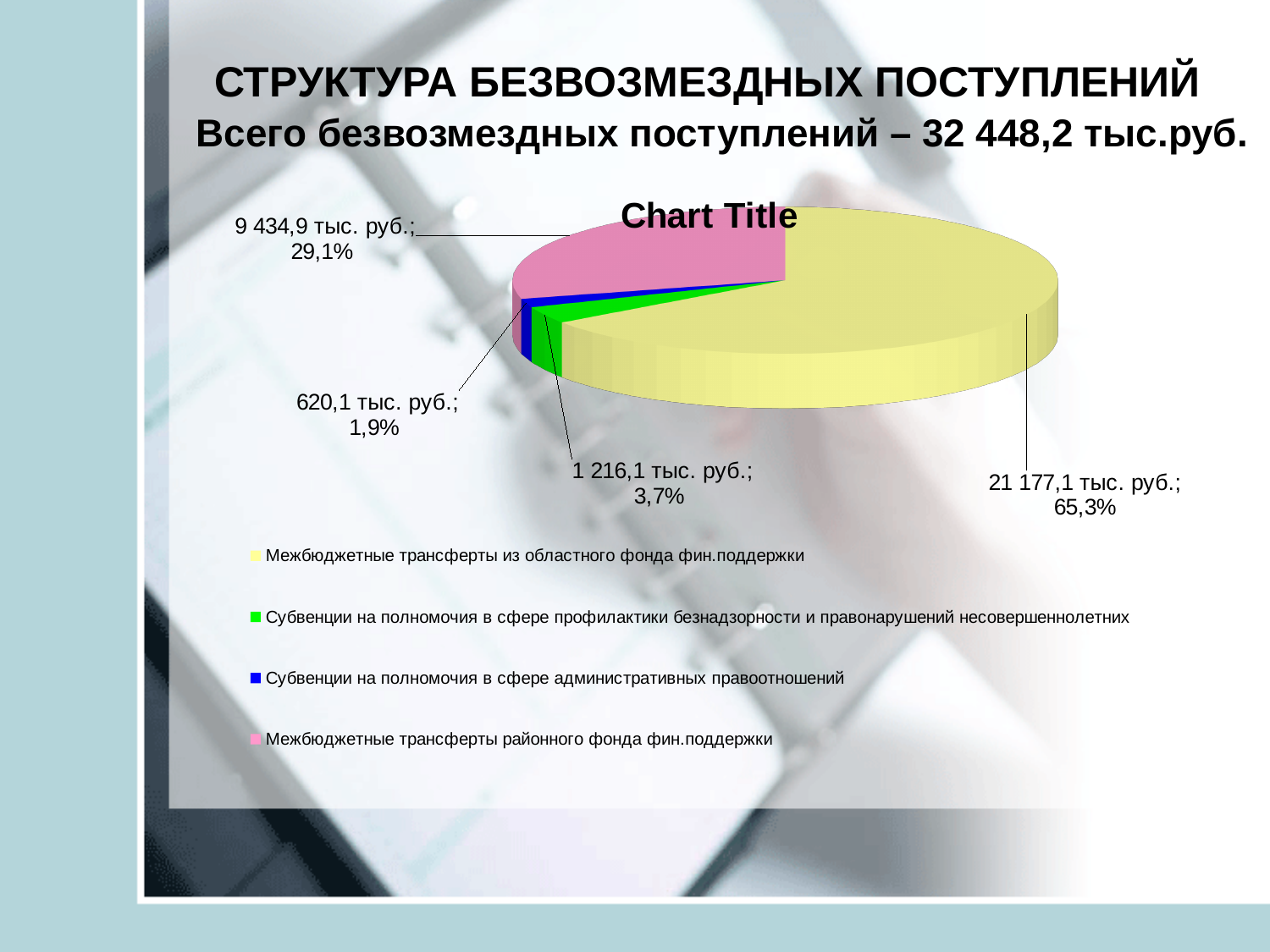
What kind of chart is shown on the slide? pie chart What share of the pie is Субвенции на полномочия в сфере административных правоотношений? 1,9% What value is shown for Межбюджетные трансферты из областного фонда фин.поддержки? 21 177,1 тыс. руб. How many entries does the legend list? 4 How many slices does the pie chart have? 4 What share of the pie is Межбюджетные трансферты районного фонда фин.поддержки? 29,1% What colour is the slice for Межбюджетные трансферты районного фонда фин.поддержки? pink Which category has the smallest slice of the pie? Субвенции на полномочия в сфере административных правоотношений What value is shown for Субвенции на полномочия в сфере профилактики безнадзорности и правонарушений несовершеннолетних? 1 216,1 тыс. руб. What is the difference in percentage share between Межбюджетные трансферты из областного фонда фин.поддержки and Межбюджетные трансферты районного фонда фин.поддержки? 36,2% Which category has the largest slice of the pie? Межбюджетные трансферты из областного фонда фин.поддержки Which is larger: Межбюджетные трансферты районного фонда фин.поддержки or Субвенции на полномочия в сфере профилактики безнадзорности и правонарушений несовершеннолетних? Межбюджетные трансферты районного фонда фин.поддержки